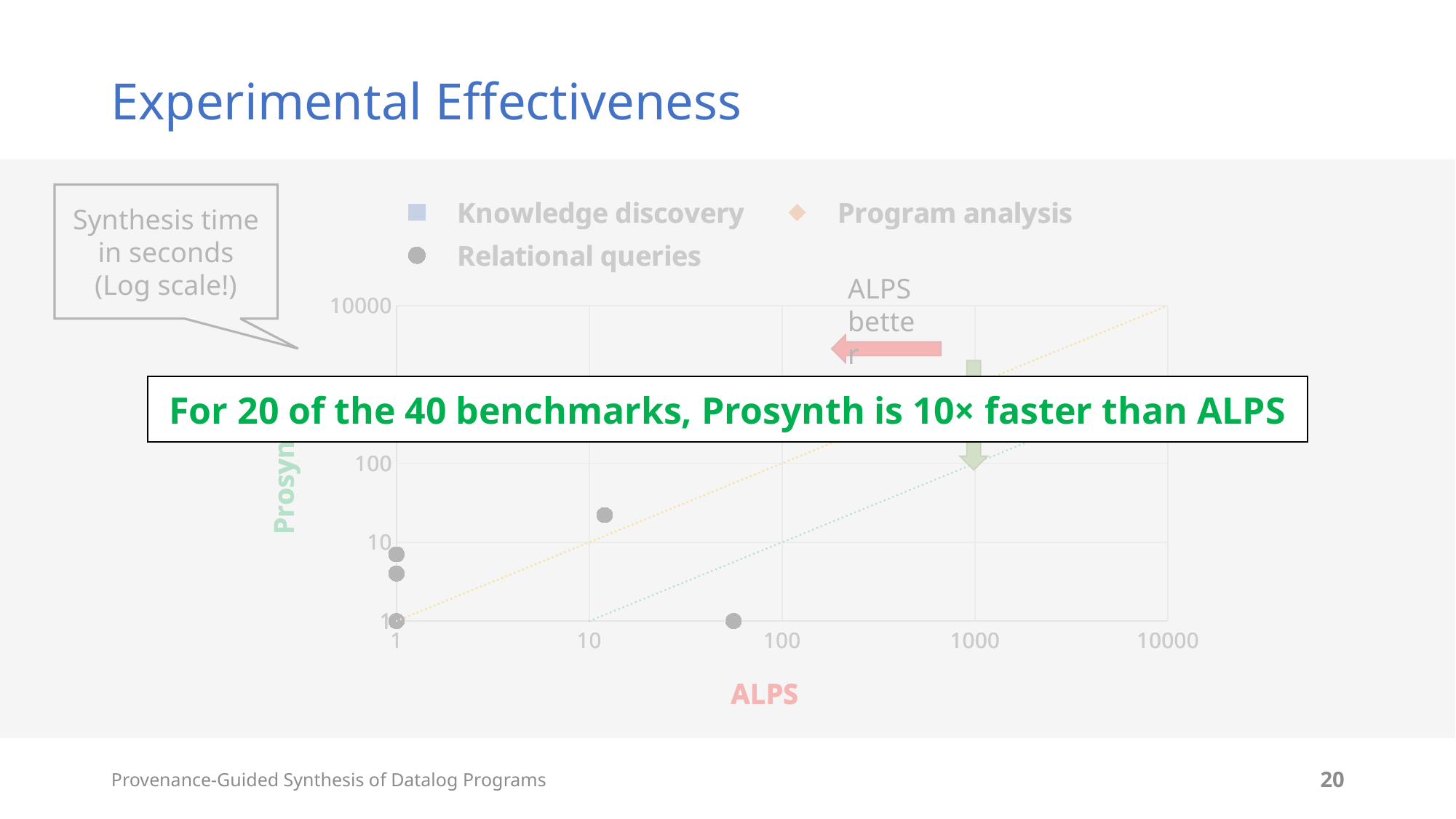
Is the Prosynth value of the highest visible Relational queries point greater or less than 100? less What label is on the x axis of the chart? ALPS What kind of chart is shown on the slide? scatter chart How many series does the chart's legend list? 3 Is the ALPS value of the rightmost visible Relational queries point greater or less than 10? greater How many Relational queries data points are visible on the chart? 5 Which series in the legend is marked with a gray circle? Relational queries What is the largest tick value shown on the x axis of the chart? 10000